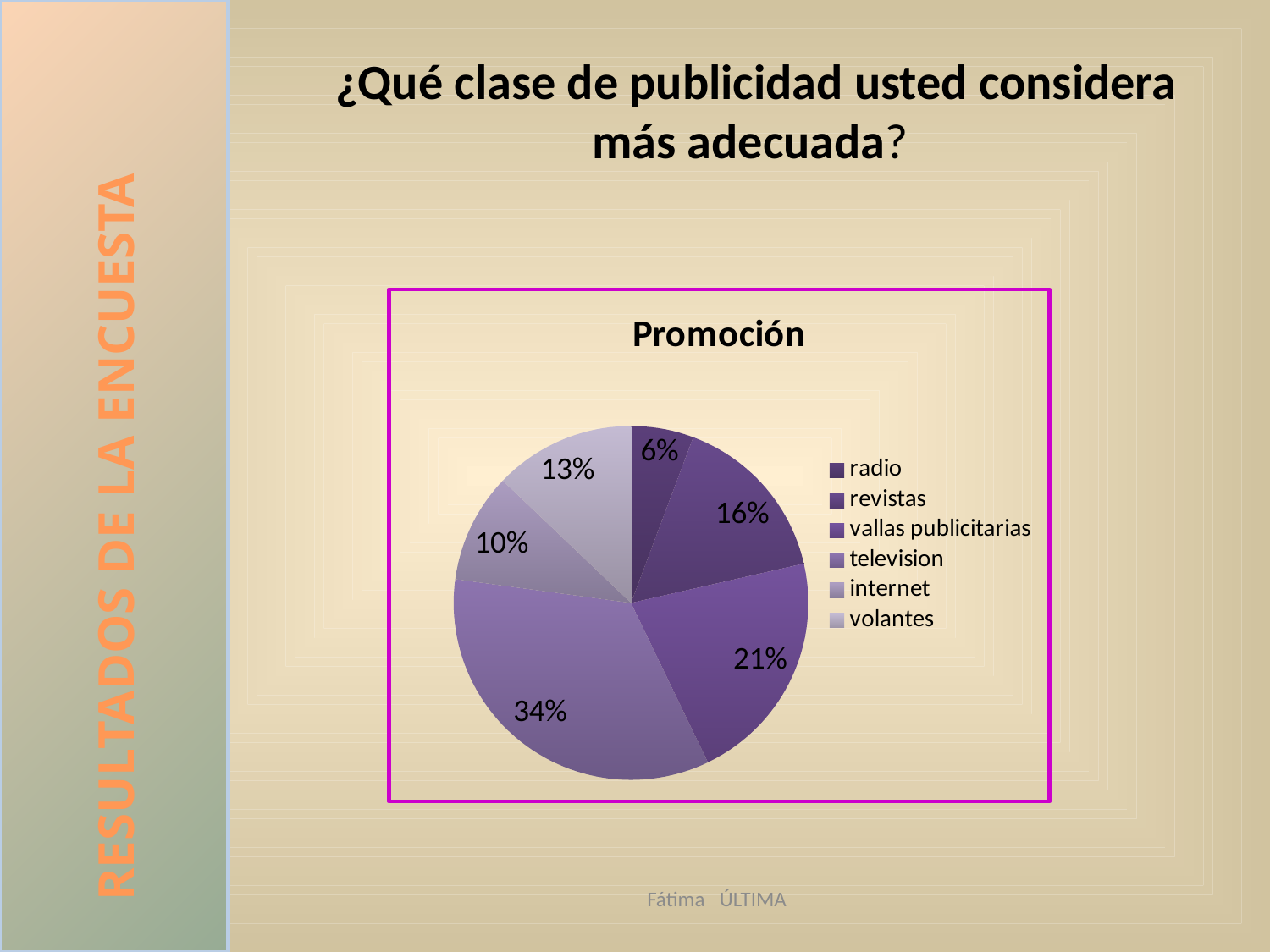
Which is larger, the share for vallas publicitarias or the share for revistas? vallas publicitarias How many slices does the pie chart have? 6 Which category has the largest share of the pie? television What kind of chart is shown on the slide? pie chart Which category has the smallest share of the pie? radio What percentage is shown for television? 34% What percentage is shown for vallas publicitarias? 21% What is the difference between the shares for revistas and volantes? 3% How many entries does the legend list? 6 What percentage is shown for radio? 6% What percentage is shown for internet? 10% What is the title of the chart? Promoción